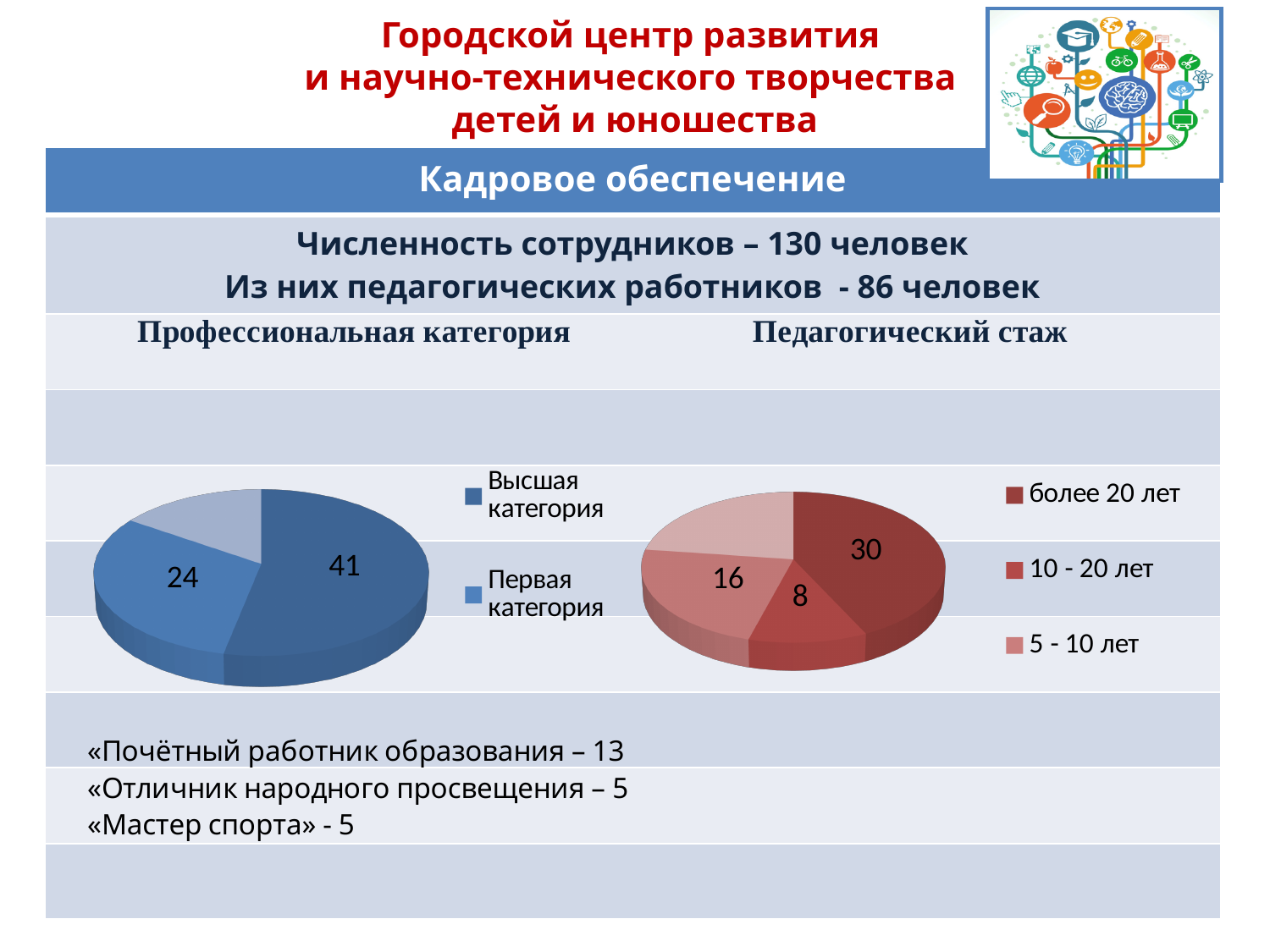
In the right chart (Педагогический стаж), what is the total of the three labelled slices? 54 In the right chart (Педагогический стаж), which category has the smallest slice? 10 - 20 лет In the right chart (Педагогический стаж), what is the value for более 20 лет? 30 In the left chart (Профессиональная категория), what is the difference between Высшая категория and Первая категория? 17 What kind of chart is the left chart (Профессиональная категория)? pie chart In the left chart (Профессиональная категория), what is the value for Высшая категория? 41 In the right chart (Педагогический стаж), what is the value for 5 - 10 лет? 16 In the left chart (Профессиональная категория), what is the value for Первая категория? 24 In the right chart (Педагогический стаж), which category has the largest slice? более 20 лет In the left chart (Профессиональная категория), which is larger: Высшая категория or Первая категория? Высшая категория How many entries does the legend of the left chart (Профессиональная категория) list? 2 In the right chart (Педагогический стаж), what is the value for 10 - 20 лет? 8